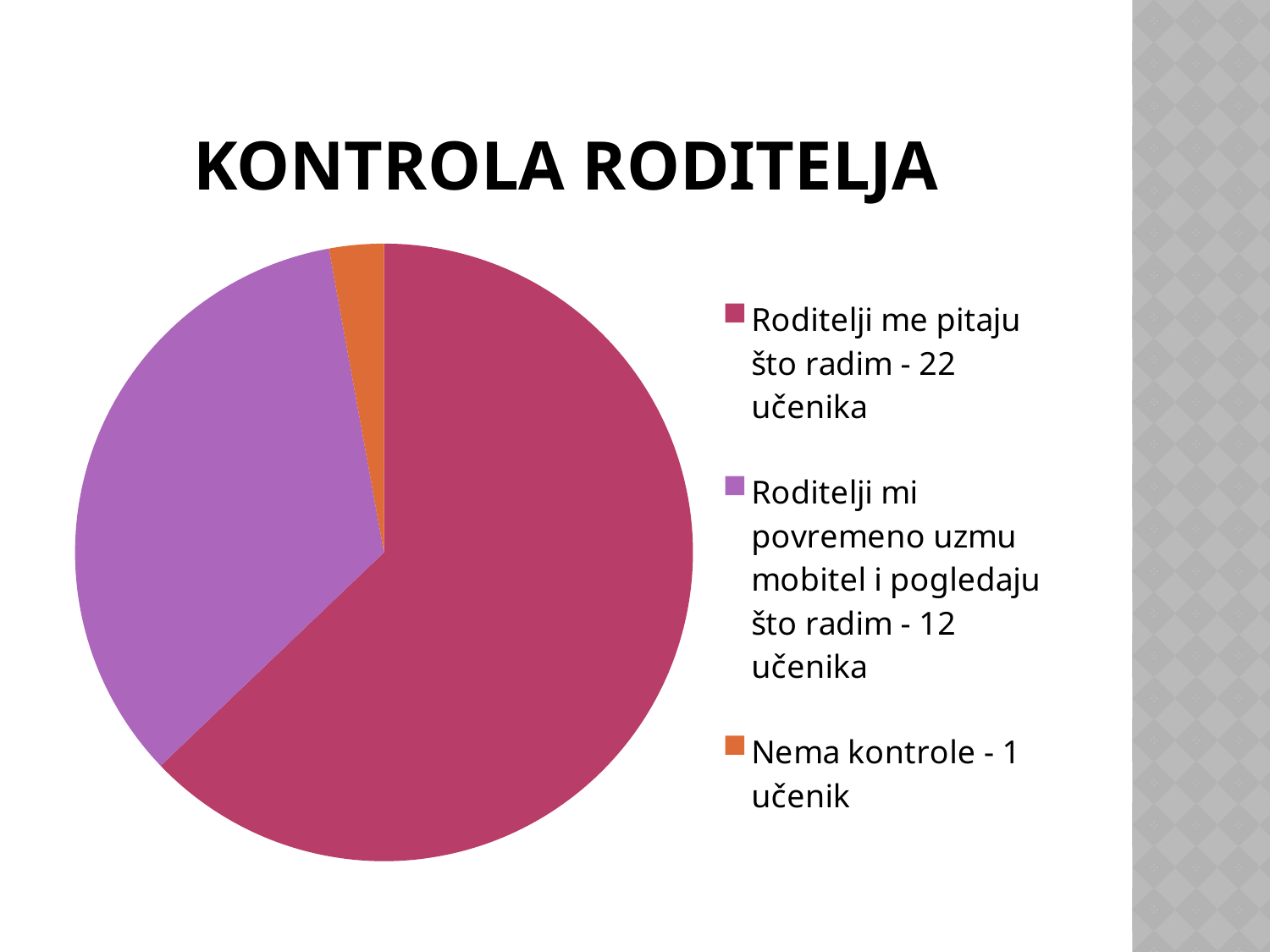
What kind of chart is shown on the slide? pie chart Which category has the largest slice of the pie? Roditelji me pitaju što radim How many students answered "Nema kontrole"? 1 učenik Which is larger: the slice for "Roditelji mi povremeno uzmu mobitel i pogledaju što radim" or the slice for "Nema kontrole"? Roditelji mi povremeno uzmu mobitel i pogledaju što radim What colour is the slice for "Nema kontrole"? orange Which category has the smallest slice of the pie? Nema kontrole What is the title of the chart on the slide? KONTROLA RODITELJA How many entries does the legend list? 3 How many students answered "Roditelji me pitaju što radim"? 22 učenika How many students answered "Roditelji mi povremeno uzmu mobitel i pogledaju što radim"? 12 učenika What is the difference between the number of students for "Roditelji me pitaju što radim" and "Roditelji mi povremeno uzmu mobitel i pogledaju što radim"? 10 How many slices does the pie chart have? 3